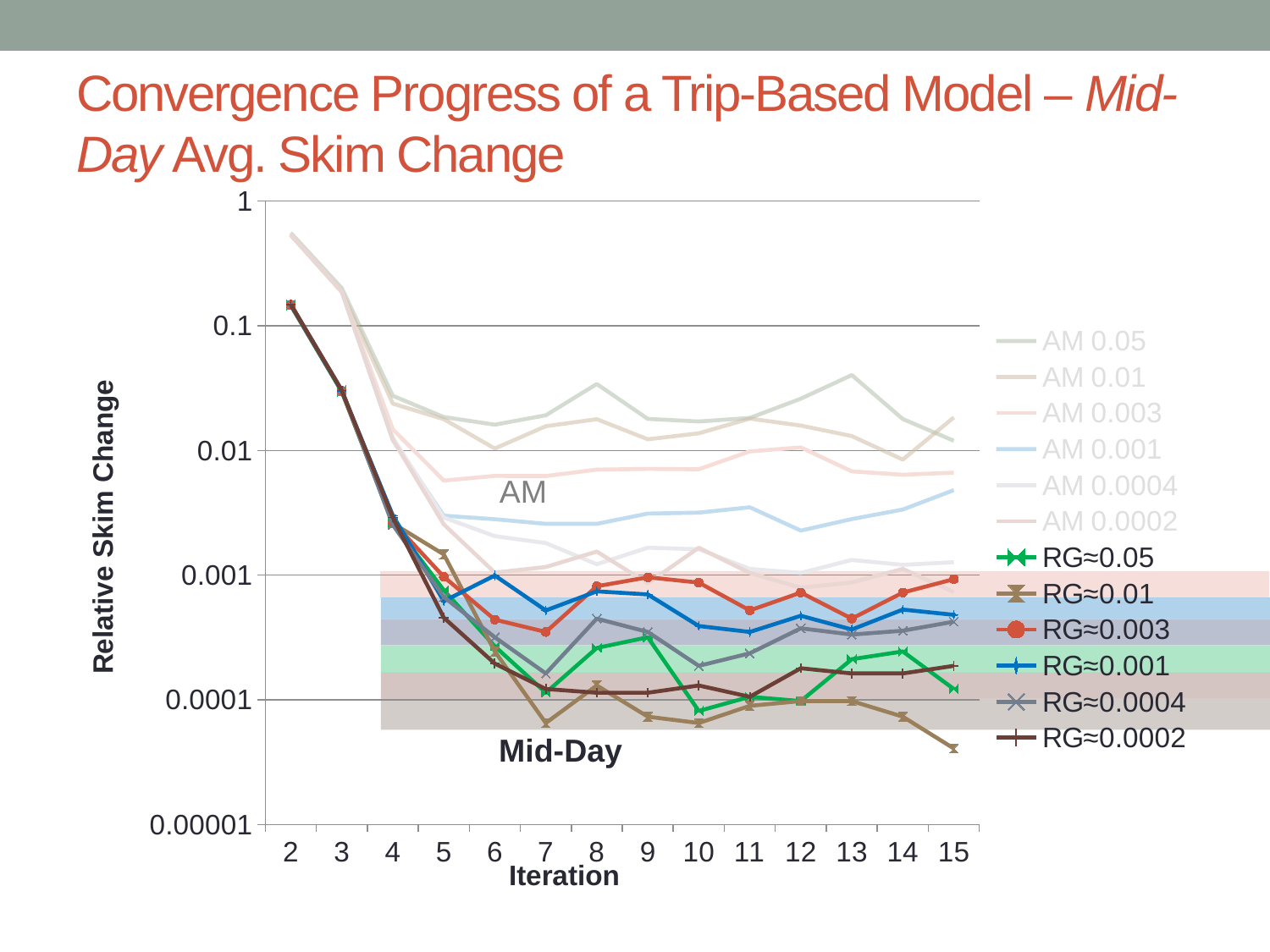
What is the title of the y axis? Relative Skim Change Does the RG≈0.003 series rise or fall from iteration 2 to iteration 7? fall Is the value for RG≈0.01 at iteration 15 greater or less than 0.0001? less At iteration 15, which is larger: RG≈0.003 or RG≈0.01? RG≈0.003 What kind of chart is shown on the slide? line chart Is the value for RG≈0.0002 at iteration 12 greater or less than 0.0001? greater Is the value for RG≈0.003 at iteration 2 greater or less than 0.1? greater Among the RG series, which has the lowest value at iteration 15? RG≈0.01 What is the title of the x axis? Iteration How many series does the legend list? 12 How many iterations are labelled along the x axis? 14